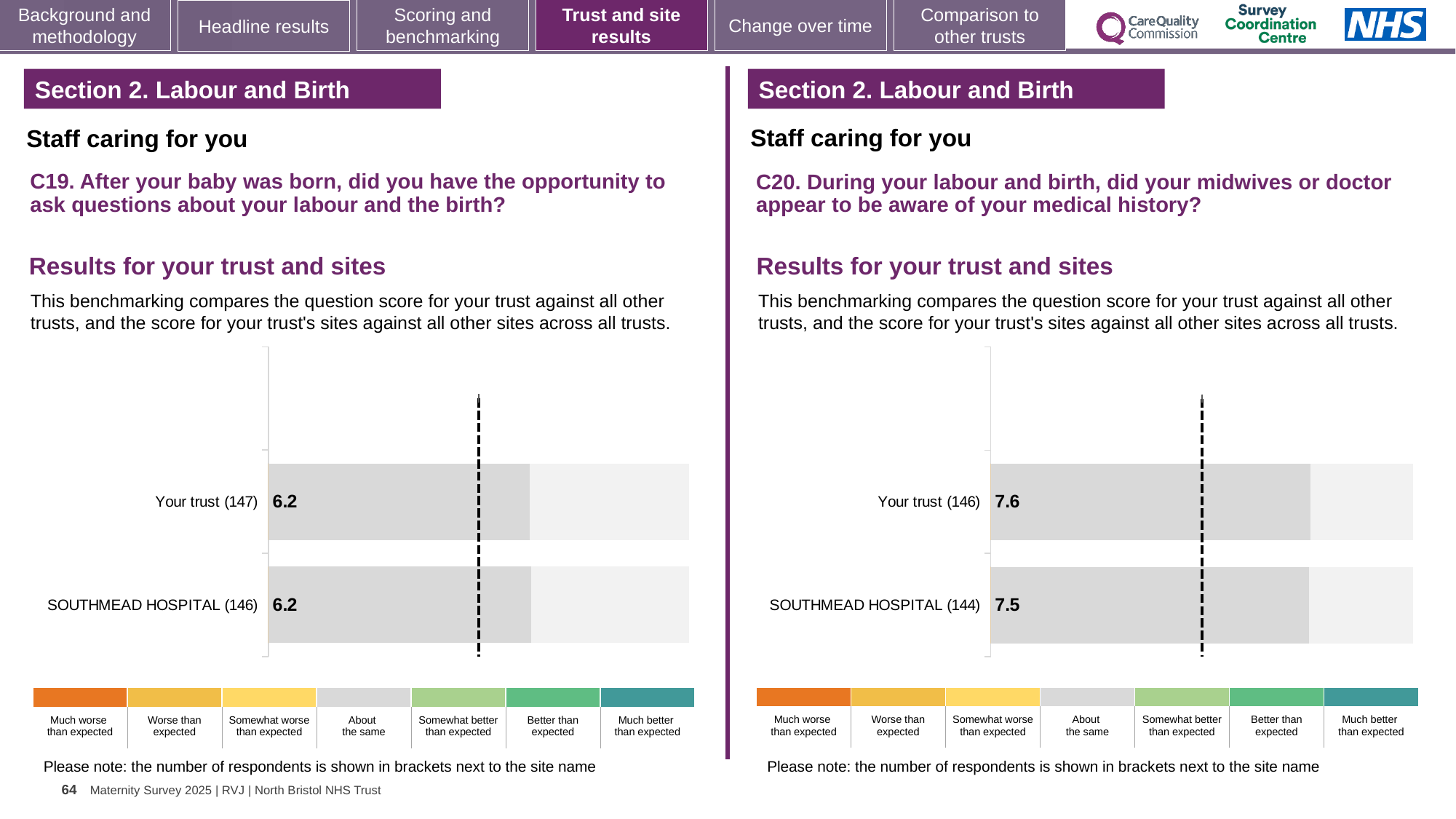
In the C19 chart on the left, what is the difference between the score for Your trust and the score for SOUTHMEAD HOSPITAL? 0 In the C20 chart on the right, what is the score for Your trust? 7.6 What type of chart is used for the C20 results on the right? Bar chart In the C20 chart on the right, what is the difference between the score for Your trust and the score for SOUTHMEAD HOSPITAL? 0.1 How many bars are shown in the C19 chart on the left? 2 In the C19 chart on the left, how many respondents are shown in brackets for SOUTHMEAD HOSPITAL? 146 In the C20 chart on the right, how many respondents are shown in brackets for Your trust? 146 In the C19 chart on the left, what is the score for Your trust? 6.2 In the C19 chart on the left, what is the score for SOUTHMEAD HOSPITAL? 6.2 In the C20 chart on the right, what is the score for SOUTHMEAD HOSPITAL? 7.5 How many bars are shown in the C20 chart on the right? 2 In the C20 chart on the right, which has the higher score, Your trust or SOUTHMEAD HOSPITAL? Your trust